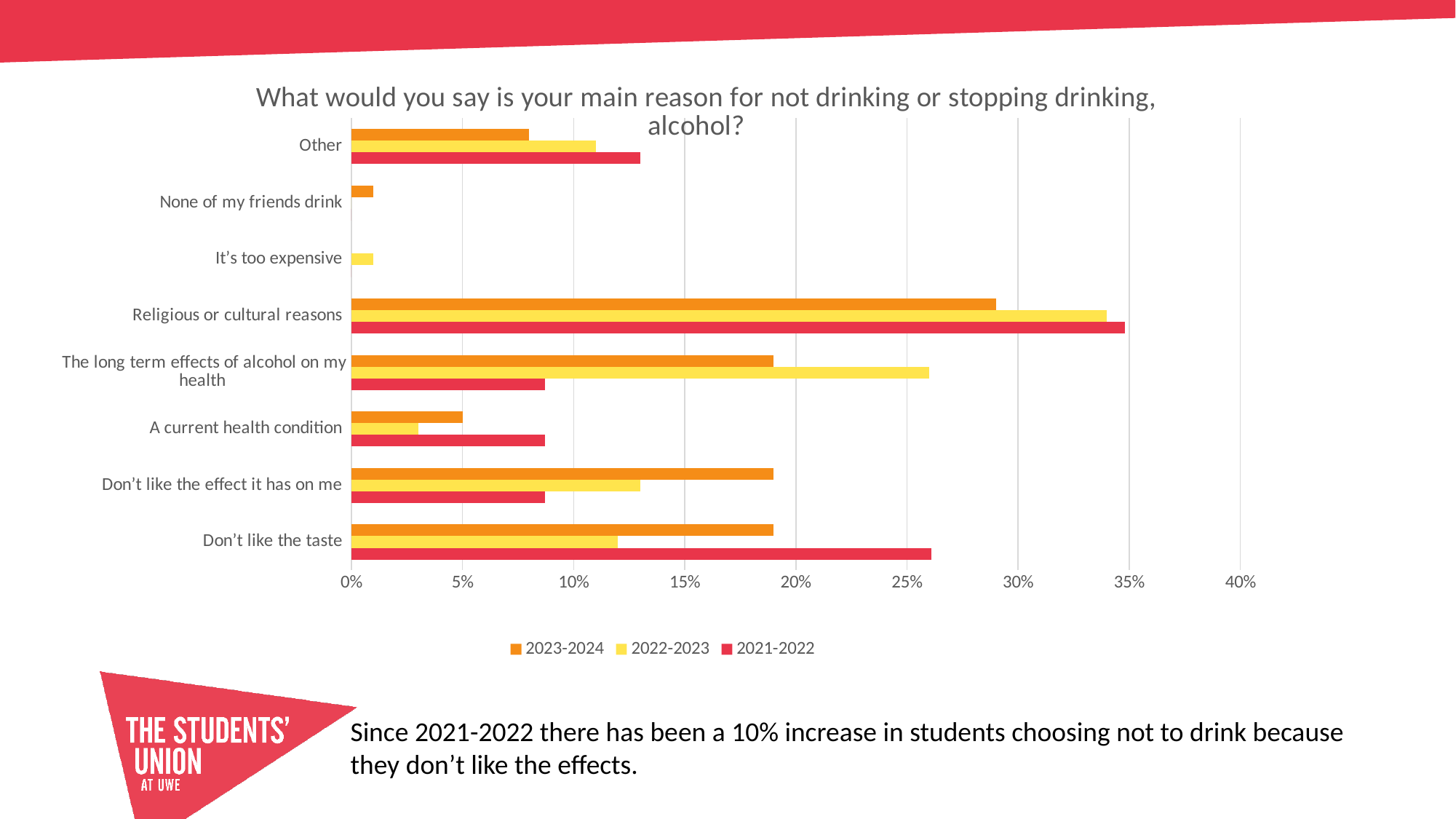
Which category has the highest value for the 2021-2022 series? Religious or cultural reasons Is the 2023-2024 value for A current health condition greater or less than 10%? less Is the 2023-2024 value for Religious or cultural reasons greater or less than 25%? greater Is the 2022-2023 value for The long term effects of alcohol on my health greater or less than 25%? greater Which series is shown in yellow in the legend? 2022-2023 What kind of chart is shown on the slide? Bar chart For The long term effects of alcohol on my health, which series has the larger value: 2022-2023 or 2023-2024? 2022-2023 Which category has the highest value for the 2023-2024 series? Religious or cultural reasons For Don't like the taste, which series has the larger value: 2021-2022 or 2022-2023? 2021-2022 How many series does the legend list? 3 How many reason categories are plotted on the chart? 8